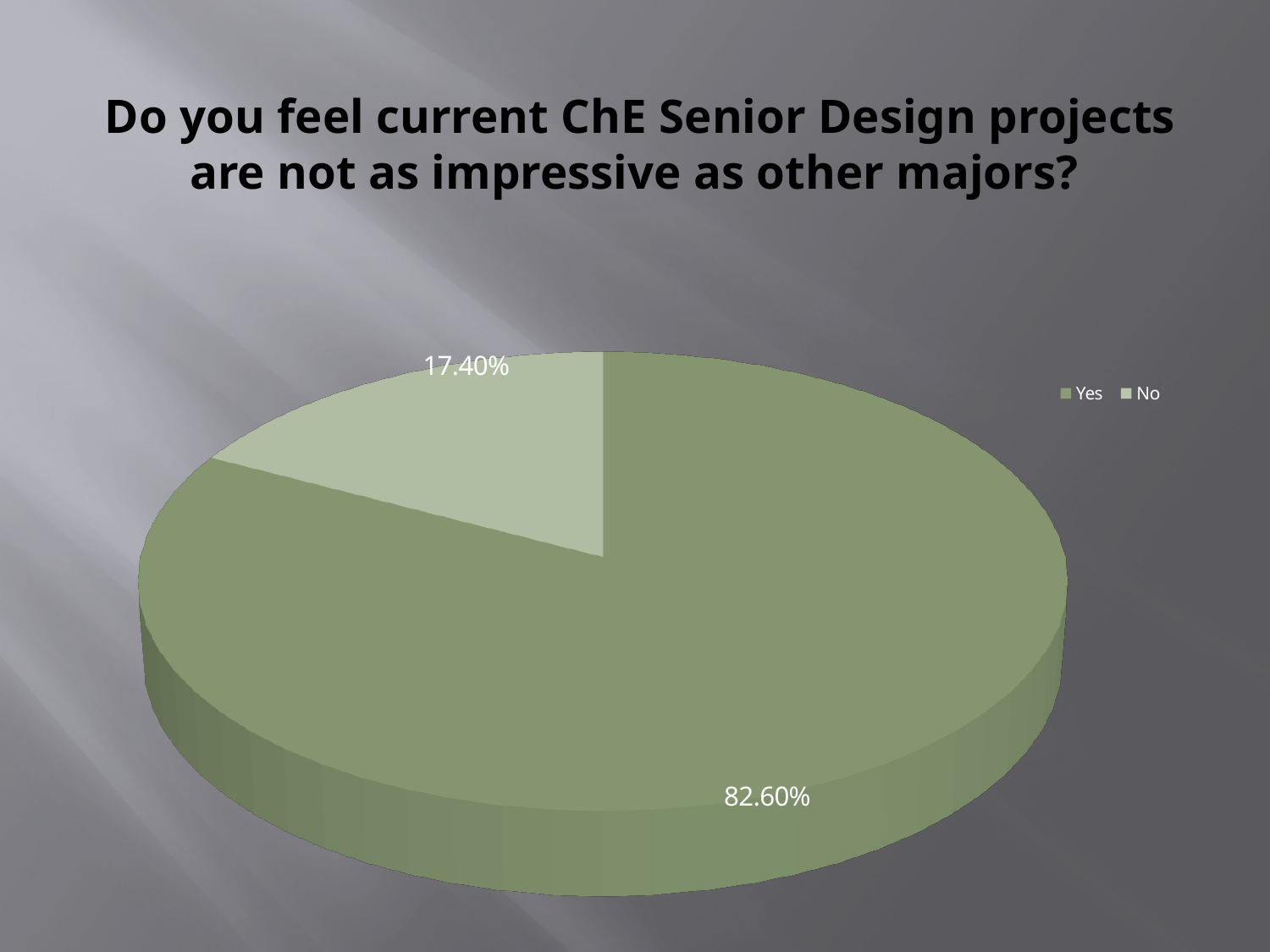
What percentage of respondents answered Yes? 82.60% How many entries does the legend list? 2 What is the title of the chart? Do you feel current ChE Senior Design projects are not as impressive as other majors? Which response has the largest share of the pie? Yes How many slices does the pie chart have? 2 What percentage of respondents answered No? 17.40% Which is larger, the share for Yes or the share for No? Yes Which response has the smallest share of the pie? No What is the difference between the Yes and No percentages? 65.20% What kind of chart is shown on the slide? pie chart What are the two legend entries? Yes and No